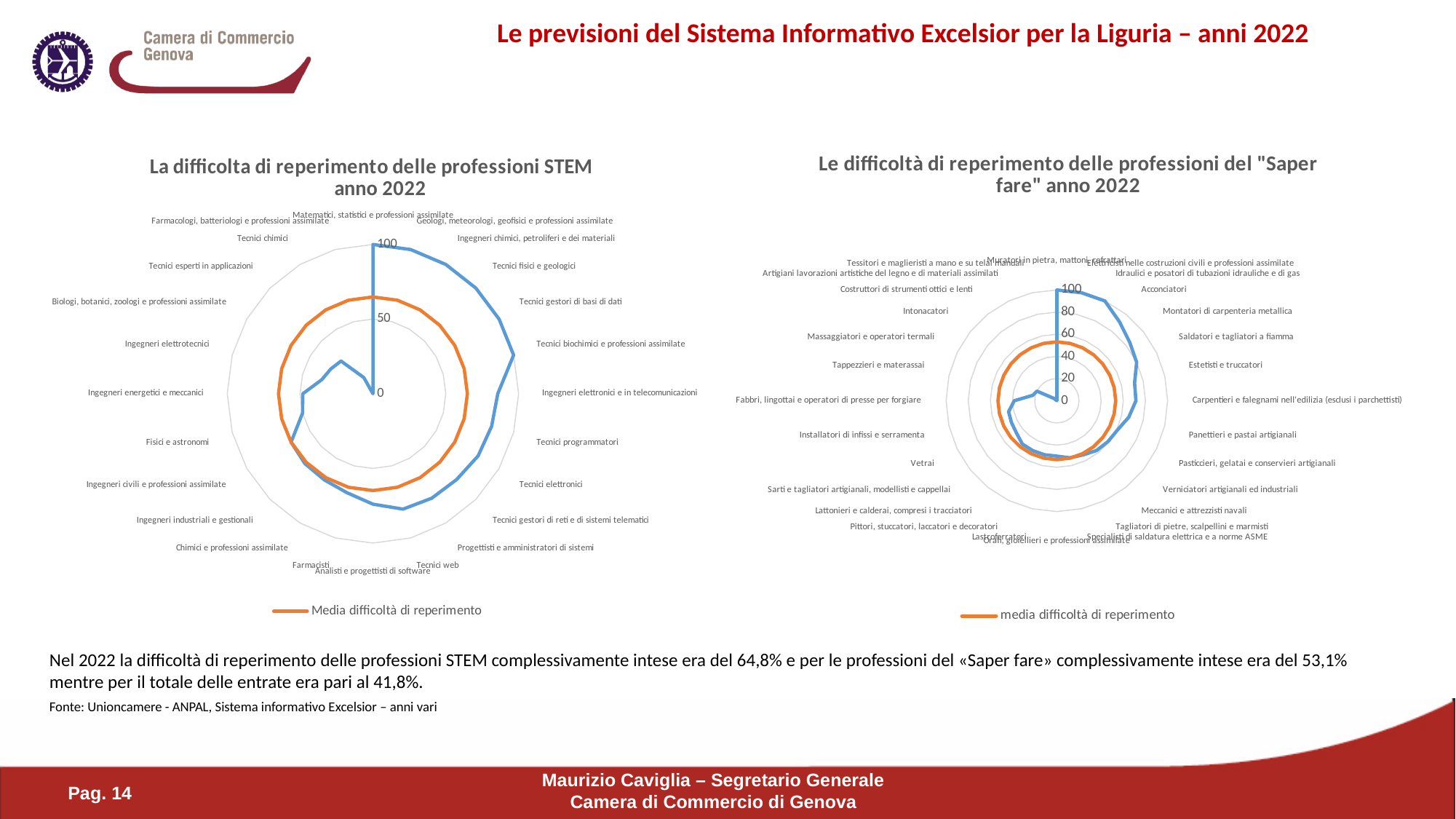
What kind of chart is the right chart titled "Le difficoltà di reperimento delle professioni del "Saper fare" anno 2022"? Radar chart In the right chart (professioni del "Saper fare"), how many series does the legend list? 1 In the left chart (professioni STEM), is the value for Ingegneri elettronici e in telecomunicazioni greater or less than 50? greater In the right chart (professioni del "Saper fare"), is the media difficoltà di reperimento line greater or less than 40? greater In the right chart (professioni del "Saper fare"), is the value for Acconciatori greater or less than 60? greater In the left chart (professioni STEM), what is the legend entry shown below the chart? Media difficoltà di reperimento What kind of chart is the left chart titled "La difficolta di reperimento delle professioni STEM anno 2022"? Radar chart